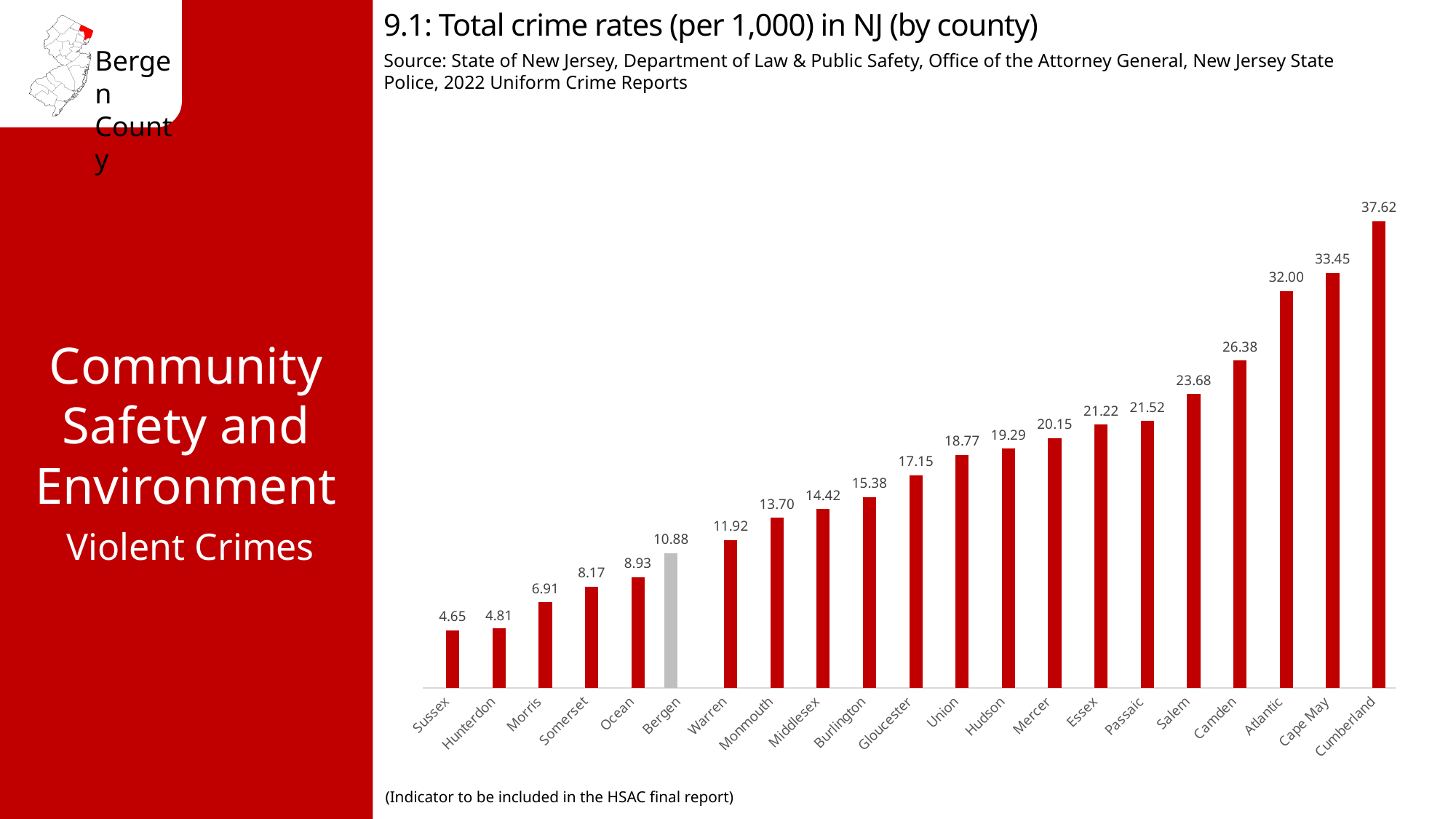
What is the total crime rate per 1,000 for Bergen County? 10.88 What is the difference between the crime rates of Cape May and Atlantic? 1.45 How many counties are shown in the chart? 21 What is the total crime rate per 1,000 for Monmouth County? 13.70 Which county has the highest total crime rate? Cumberland What kind of chart is used on this slide? Bar chart Which county has a higher total crime rate, Hudson or Union? Hudson Which county has the lowest total crime rate? Sussex Do the crime rates rise or fall from left to right along the x axis? Rise What is the total crime rate per 1,000 for Essex County? 21.22 What is the difference between the crime rates of Cumberland and Bergen? 26.74 Which county's bar is coloured grey instead of red? Bergen